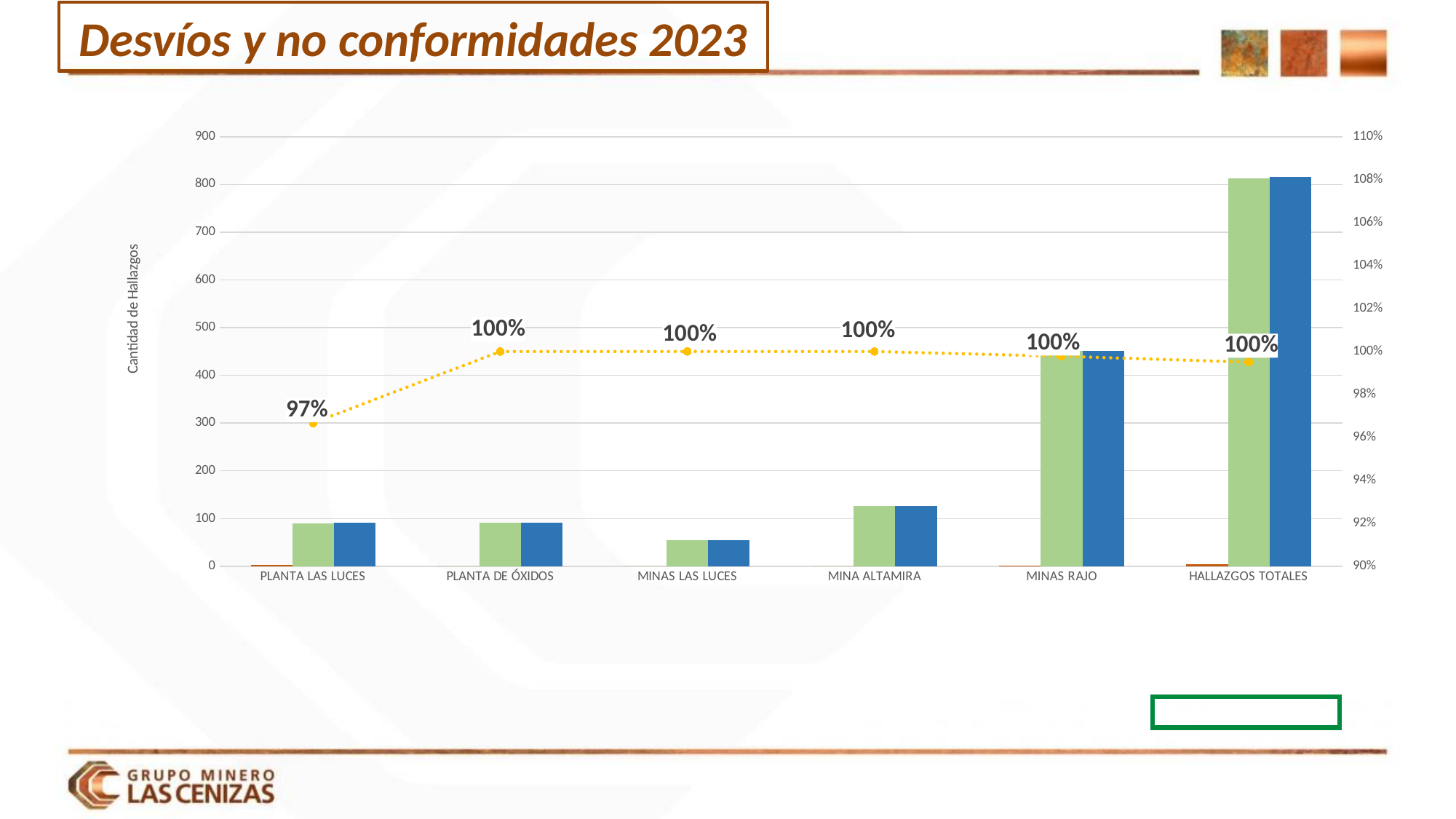
What percentage is shown for PLANTA LAS LUCES on the dotted line? 97% What percentage is shown for MINAS RAJO on the dotted line? 100% Which category has the lowest percentage on the dotted line? PLANTA LAS LUCES What is the title of the left vertical axis? Cantidad de Hallazgos Is the value of the green bar for MINAS RAJO greater or less than 400? greater What kind of chart is shown on the slide? Bar chart with a line Is the value of the blue bar for MINAS LAS LUCES greater or less than 100? less Are the bars for MINAS RAJO taller or shorter than the bars for MINA ALTAMIRA? taller How many categories are shown on the x axis? 6 Which category has the shortest bars? MINAS LAS LUCES Which category has the tallest bars? HALLAZGOS TOTALES